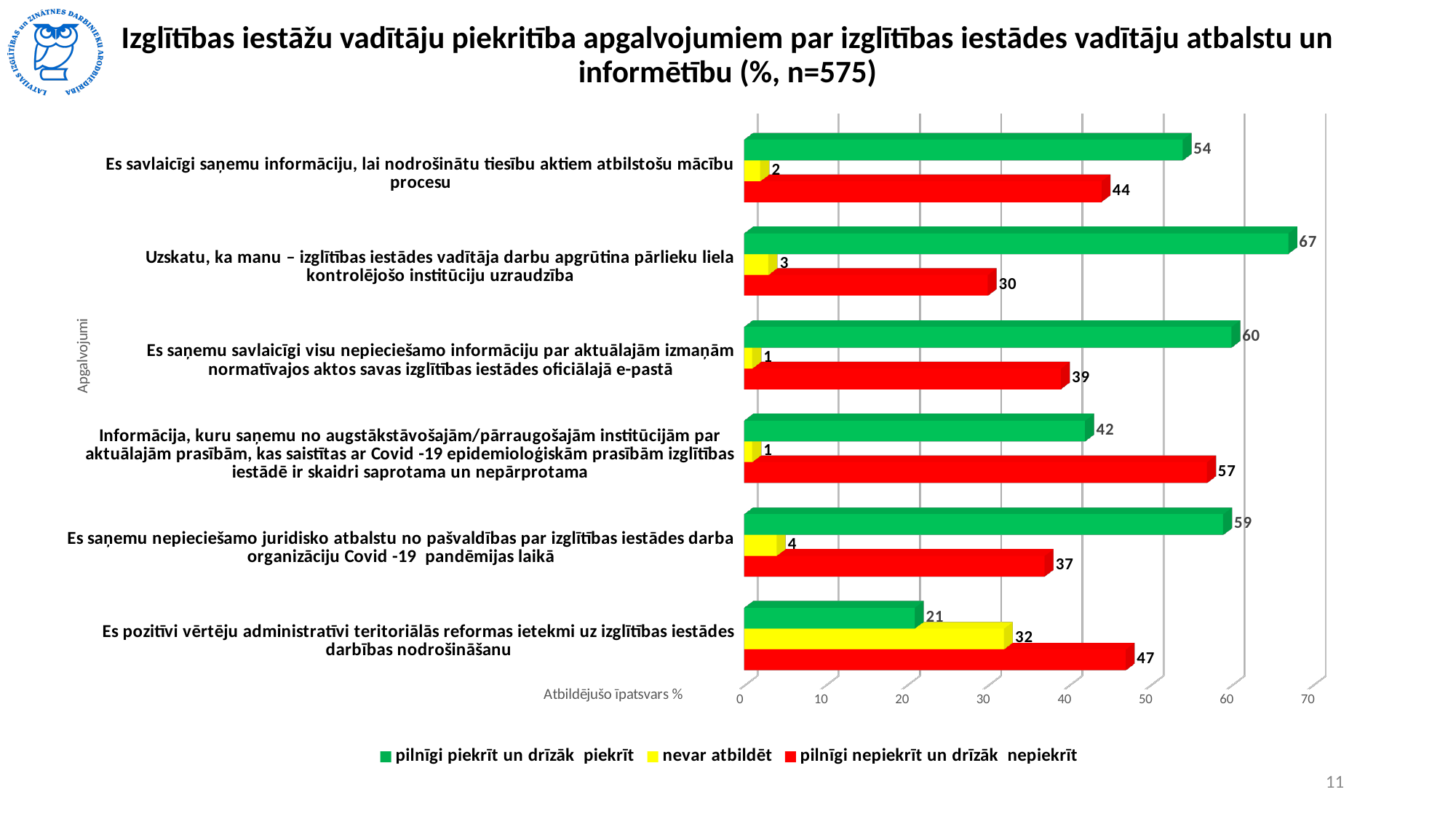
What is the value of 'pilnīgi nepiekrīt un drīzāk nepiekrīt' for the statement 'Es saņemu nepieciešamo juridisko atbalstu no pašvaldības par izglītības iestādes darba organizāciju Covid -19 pandēmijas laikā'? 37 What is the value of 'pilnīgi piekrīt un drīzāk piekrīt' for the statement 'Uzskatu, ka manu – izglītības iestādes vadītāja darbu apgrūtina pārlieku liela kontrolējošo institūciju uzraudzība'? 67 Which colour represents the series 'nevar atbildēt' in the legend? yellow How many statements (categories) are plotted on the chart? 6 What is the value of 'nevar atbildēt' for the statement 'Es pozitīvi vērtēju administratīvi teritoriālās reformas ietekmi uz izglītības iestādes darbības nodrošināšanu'? 32 What is the difference between the 'pilnīgi piekrīt un drīzāk piekrīt' and 'pilnīgi nepiekrīt un drīzāk nepiekrīt' values for the statement 'Es savlaicīgi saņemu informāciju, lai nodrošinātu tiesību aktiem atbilstošu mācību procesu'? 10 What kind of chart is shown on the slide? bar chart For the statement about Covid-19 information from higher institutions being clear and unambiguous, which is larger: 'pilnīgi piekrīt un drīzāk piekrīt' or 'pilnīgi nepiekrīt un drīzāk nepiekrīt'? pilnīgi nepiekrīt un drīzāk nepiekrīt How many series does the legend list? 3 What is the total of the three values for the statement 'Es saņemu savlaicīgi visu nepieciešamo informāciju par aktuālajām izmaiņām normatīvajos aktos savas izglītības iestādes oficiālajā e-pastā'? 100 Which statement has the highest value for 'pilnīgi piekrīt un drīzāk piekrīt'? Uzskatu, ka manu – izglītības iestādes vadītāja darbu apgrūtina pārlieku liela kontrolējošo institūciju uzraudzība Which statement has the lowest value for 'pilnīgi piekrīt un drīzāk piekrīt'? Es pozitīvi vērtēju administratīvi teritoriālās reformas ietekmi uz izglītības iestādes darbības nodrošināšanu